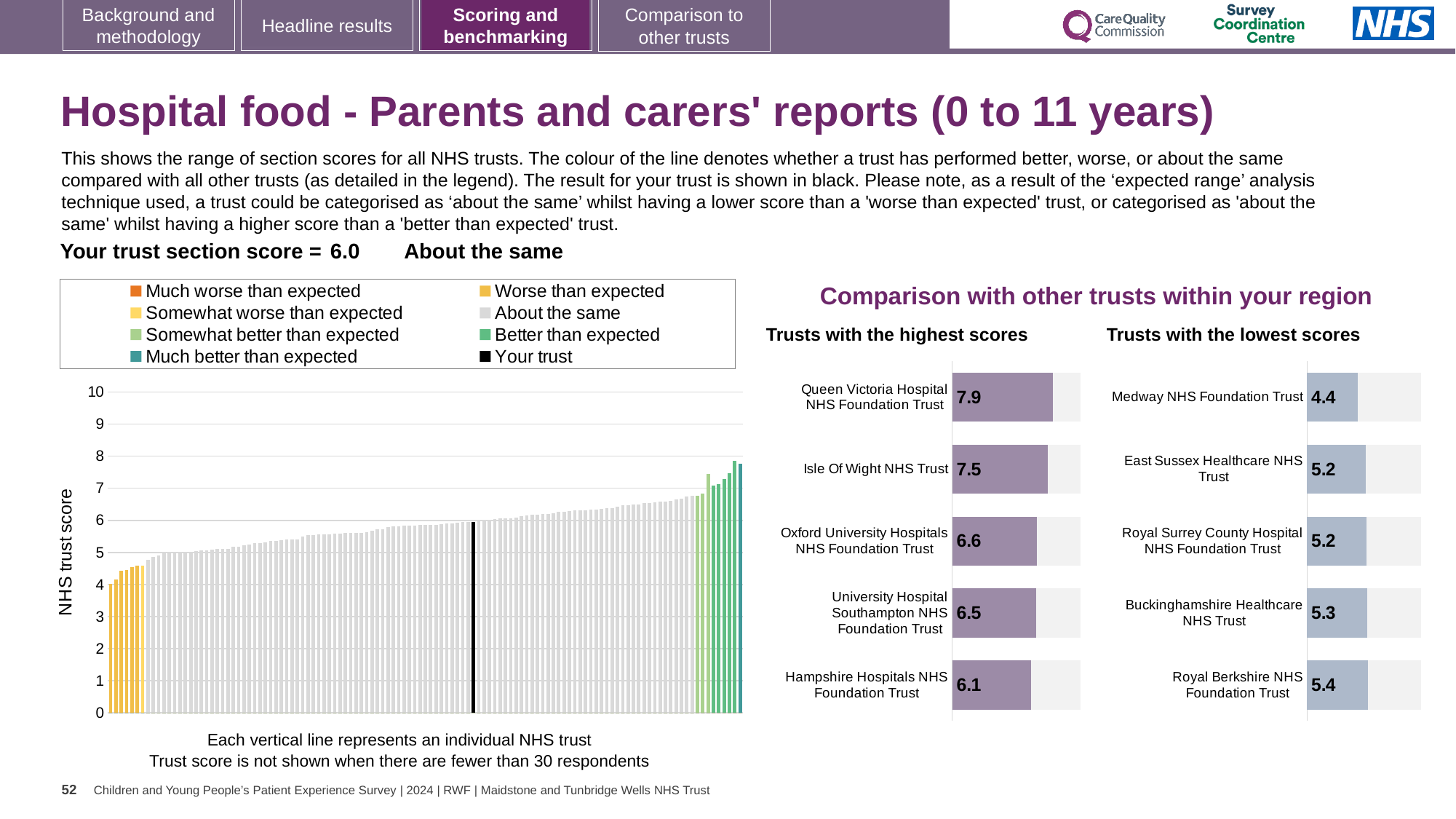
In the 'Trusts with the lowest scores' chart, which trust has the highest score? Royal Berkshire NHS Foundation Trust In the 'Trusts with the highest scores' chart, what is the difference between the scores of Queen Victoria Hospital NHS Foundation Trust and Isle Of Wight NHS Trust? 0.4 In the 'Trusts with the lowest scores' chart, what is the difference between the scores of Royal Berkshire NHS Foundation Trust and Medway NHS Foundation Trust? 1.0 How many entries does the legend of the 'NHS trust score' chart list? 8 In the 'Trusts with the lowest scores' chart, what is the score for Medway NHS Foundation Trust? 4.4 In the 'Trusts with the highest scores' chart, which trust has the lowest score? Hampshire Hospitals NHS Foundation Trust What kind of chart is the 'NHS trust score' chart on the left of the slide? bar chart In the 'Trusts with the highest scores' chart, what is the score for Queen Victoria Hospital NHS Foundation Trust? 7.9 In the 'Trusts with the highest scores' chart, which has the higher score: Oxford University Hospitals NHS Foundation Trust or University Hospital Southampton NHS Foundation Trust? Oxford University Hospitals NHS Foundation Trust How many trusts are shown in the 'Trusts with the lowest scores' chart? 5 In the 'NHS trust score' chart, do the bar values rise or fall from left to right? rise In the 'NHS trust score' chart, what is the section score for your trust (the black bar)? 6.0